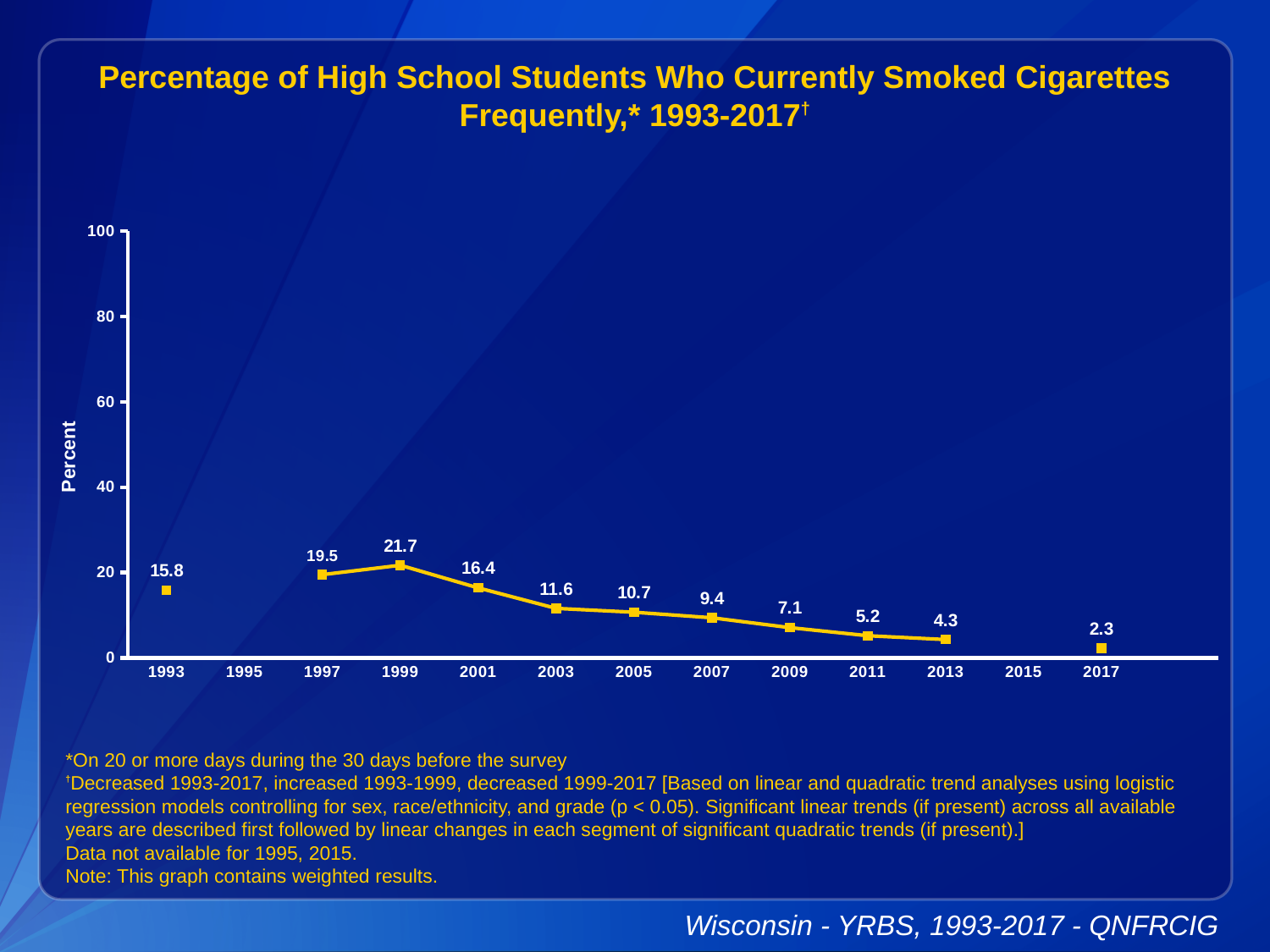
Which year has the highest percentage? 1999 Which year has a higher value, 1997 or 2001? 1997 What is the difference between the 1999 value and the 2017 value? 19.4 How many years have data points plotted on the chart? 11 What was the percentage in 1993? 15.8 What is the label on the y axis? Percent What kind of chart is shown on the slide? line chart Which year has the lowest percentage? 2017 Do the values rise or fall from 1999 to 2017? fall Is the value for 2005 greater or less than 20? less What was the percentage of high school students who currently smoked cigarettes frequently in 1999? 21.7 What value is shown for 2017? 2.3